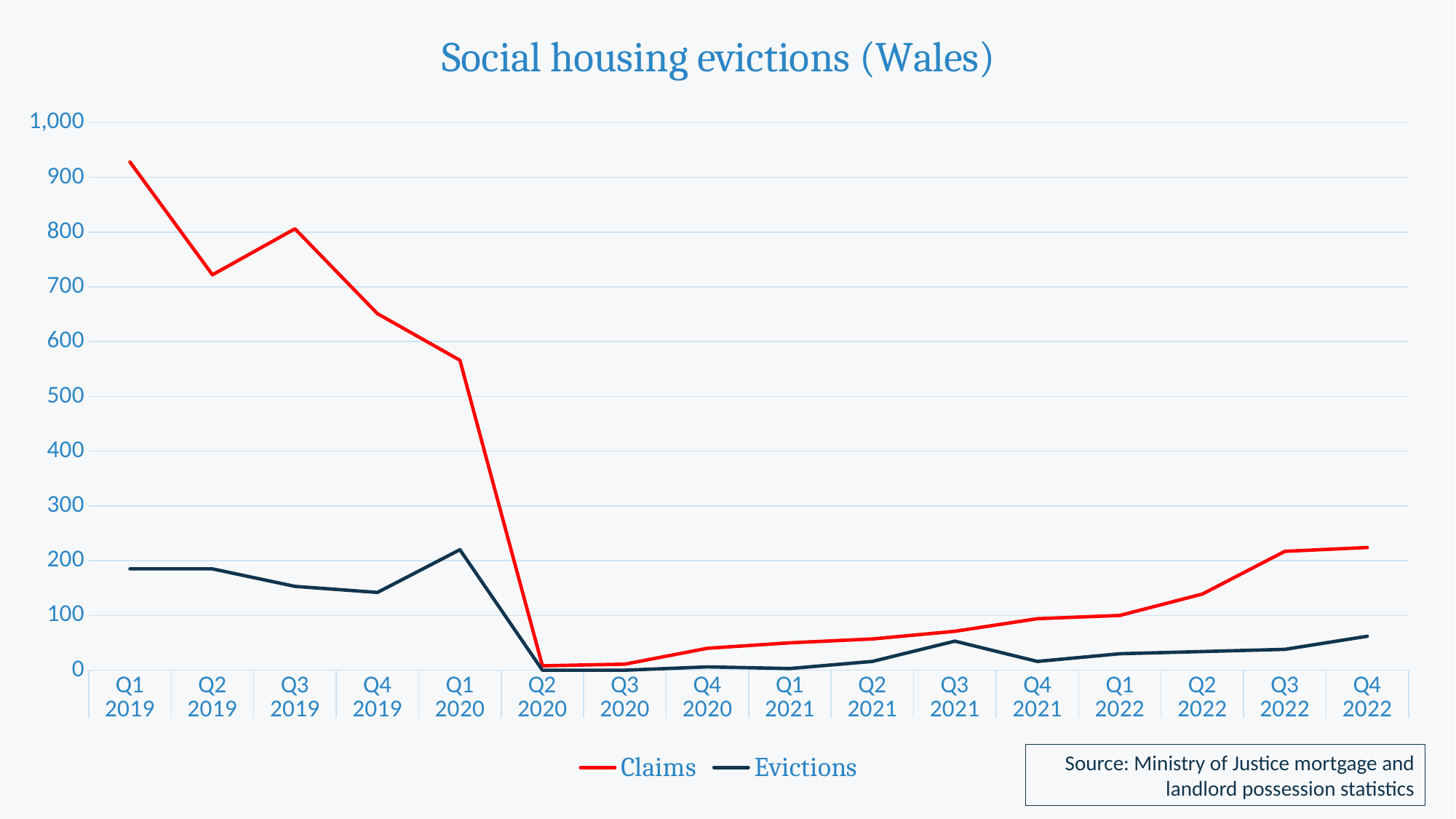
In which quarter is the Evictions series at its highest? Q1 2020 Is the value for Evictions in Q4 2022 greater or less than 100? less Is the value for Claims in Q1 2020 greater or less than 500? greater What kind of chart is shown on the slide? Line chart Is the value for Claims in Q1 2019 greater or less than 800? greater In which quarter is the Claims series at its highest? Q1 2019 How many quarters are plotted along the x axis? 16 How many series does the legend list? 2 Which series has the larger value in Q1 2019, Claims or Evictions? Claims What is the title of the chart? Social housing evictions (Wales) Do the Claims values rise or fall from Q2 2020 to Q4 2022? Rise